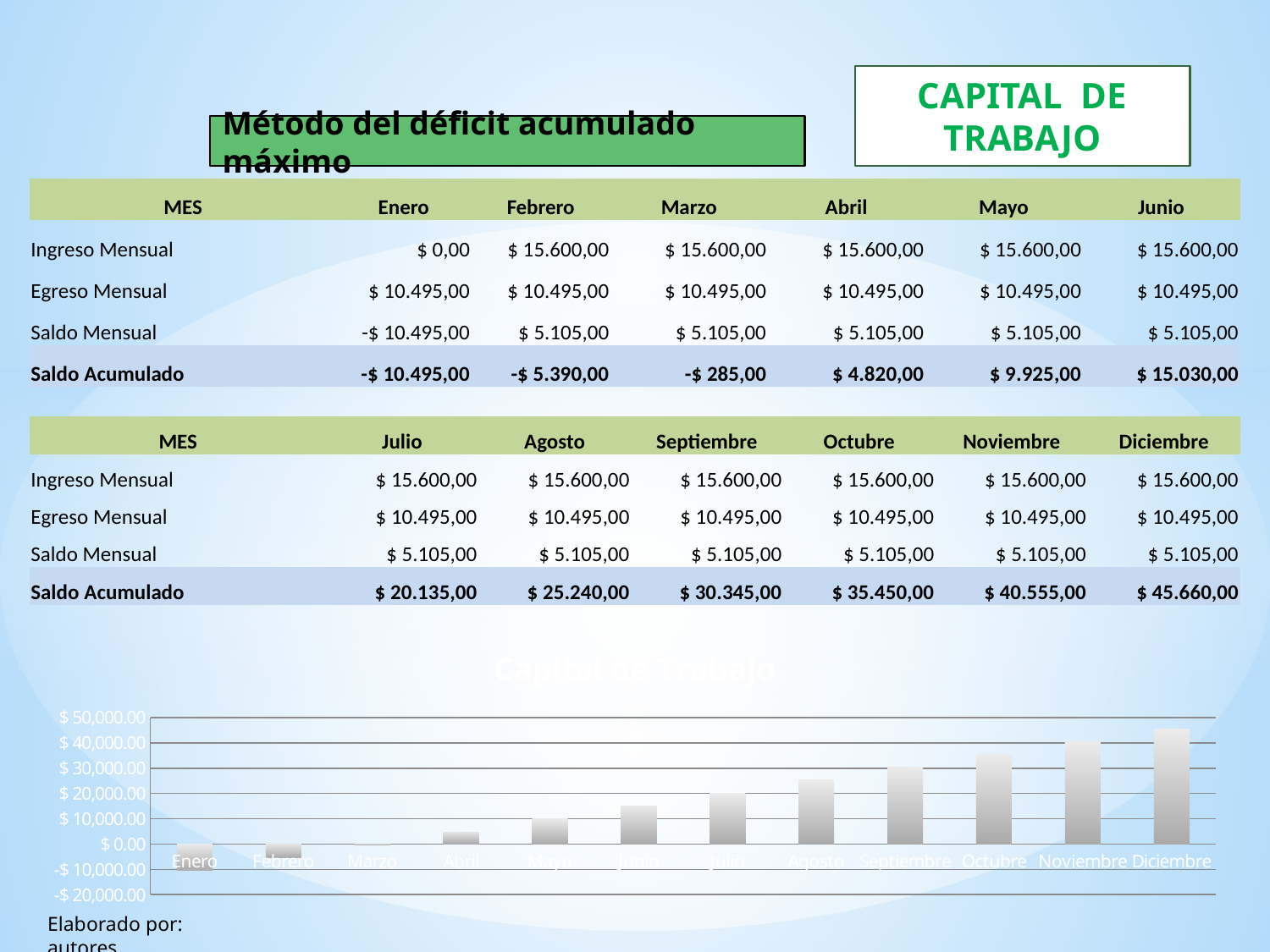
Is the value for Diciembre greater or less than $40,000.00? greater Which bar is taller, Octubre or Abril? Octubre What kind of chart is shown at the bottom of the slide? bar chart Is the value for Abril greater or less than $10,000.00? less Is the value for Febrero greater or less than $0.00? less How many months are plotted on the x axis of the chart? 12 Which month has the lowest bar in the chart? Enero Which month has the highest bar in the chart? Diciembre Do the bar values generally rise or fall from Enero to Diciembre? rise